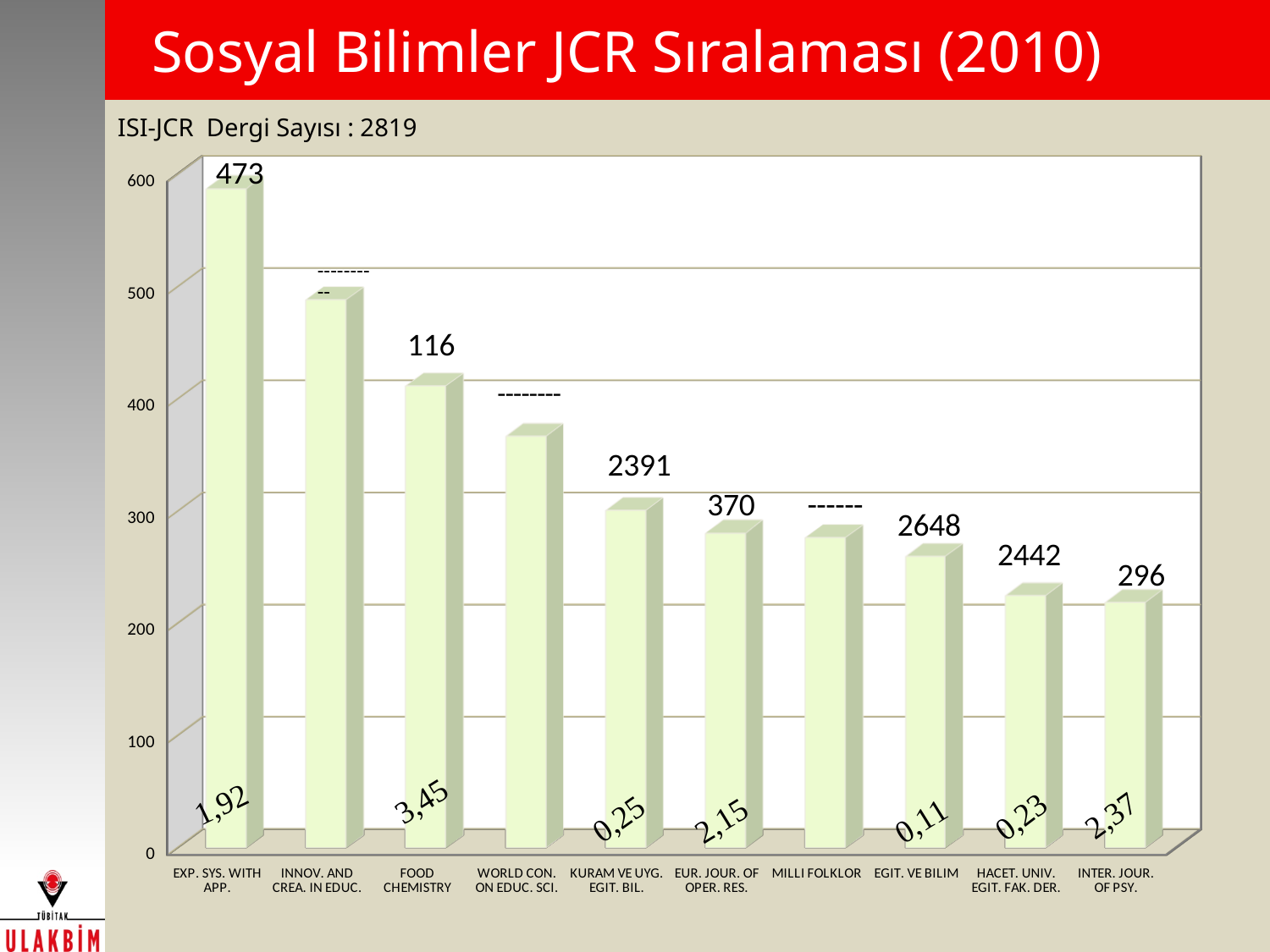
How many categories (journals) are plotted on the chart? 10 Which bar is taller, EXP. SYS. WITH APP. or FOOD CHEMISTRY? EXP. SYS. WITH APP. What is the title of the slide containing the chart? Sosyal Bilimler JCR Sıralaması (2010) What kind of chart is shown on the slide? bar chart Do the bar heights generally rise or fall from left to right across the chart? fall Which category has the shortest bar? INTER. JOUR. OF PSY. Is the bar for EXP. SYS. WITH APP. greater or less than 500? greater Is the bar for EGIT. VE BILIM greater or less than 300? less Which bar is taller, WORLD CON. ON EDUC. SCI. or MILLI FOLKLOR? WORLD CON. ON EDUC. SCI. Is the bar for INTER. JOUR. OF PSY. greater or less than 200? greater Which category has the tallest bar? EXP. SYS. WITH APP.